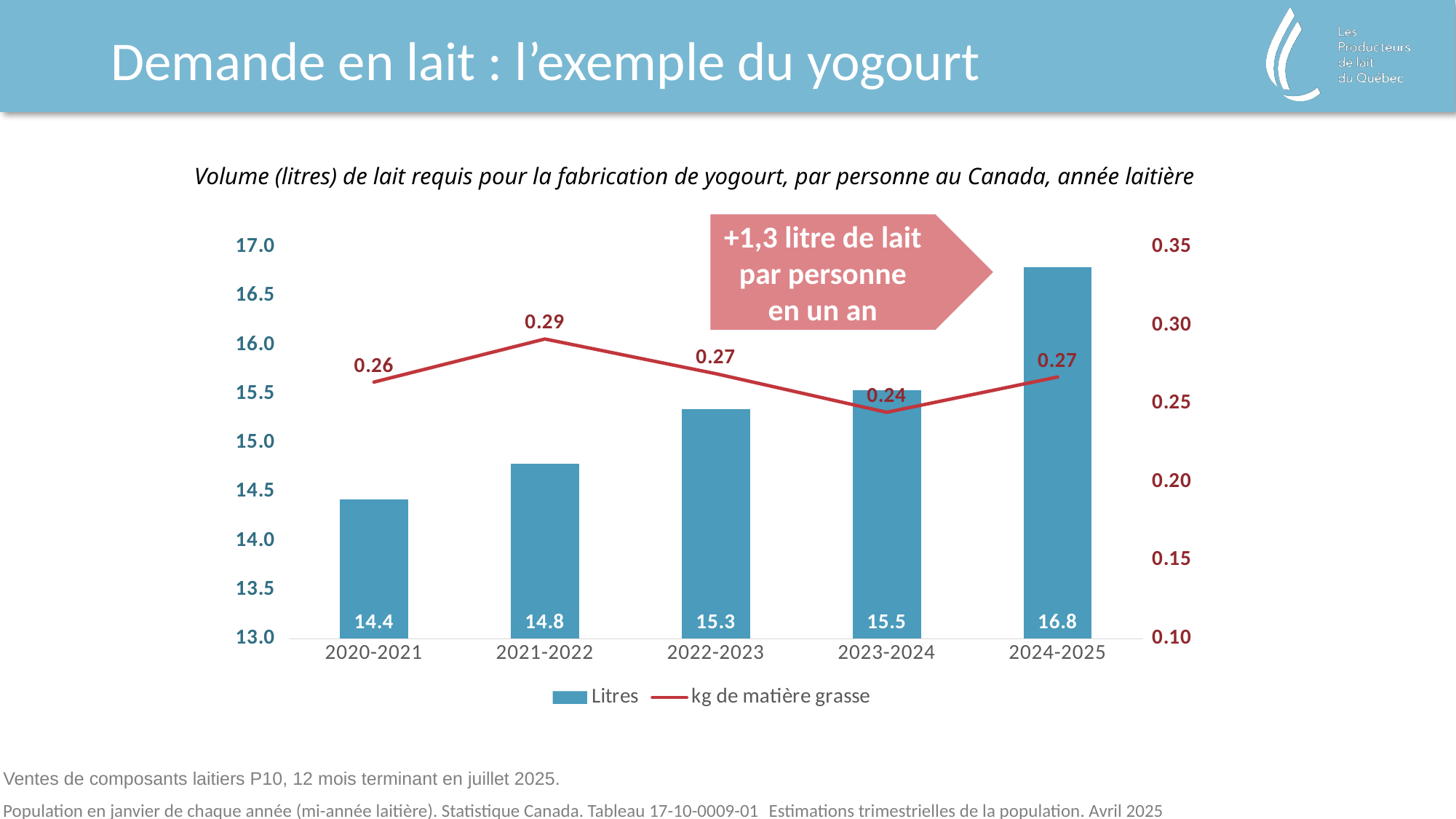
What is the Litres value for 2024-2025? 16.8 How many years are shown on the x axis? 5 What is the difference in Litres between 2024-2025 and 2023-2024? 1.3 Which year has the lowest kg de matière grasse value? 2023-2024 What is the kg de matière grasse value for 2021-2022? 0.29 What is the Litres value for 2020-2021? 14.4 Which year has the highest Litres value? 2024-2025 How many series does the legend list? 2 What kind of chart is this? Combined bar and line chart Do the Litres values rise or fall from 2020-2021 to 2024-2025? Rise Which is larger, the Litres value for 2021-2022 or for 2022-2023? 2022-2023 What is the kg de matière grasse value for 2023-2024? 0.24